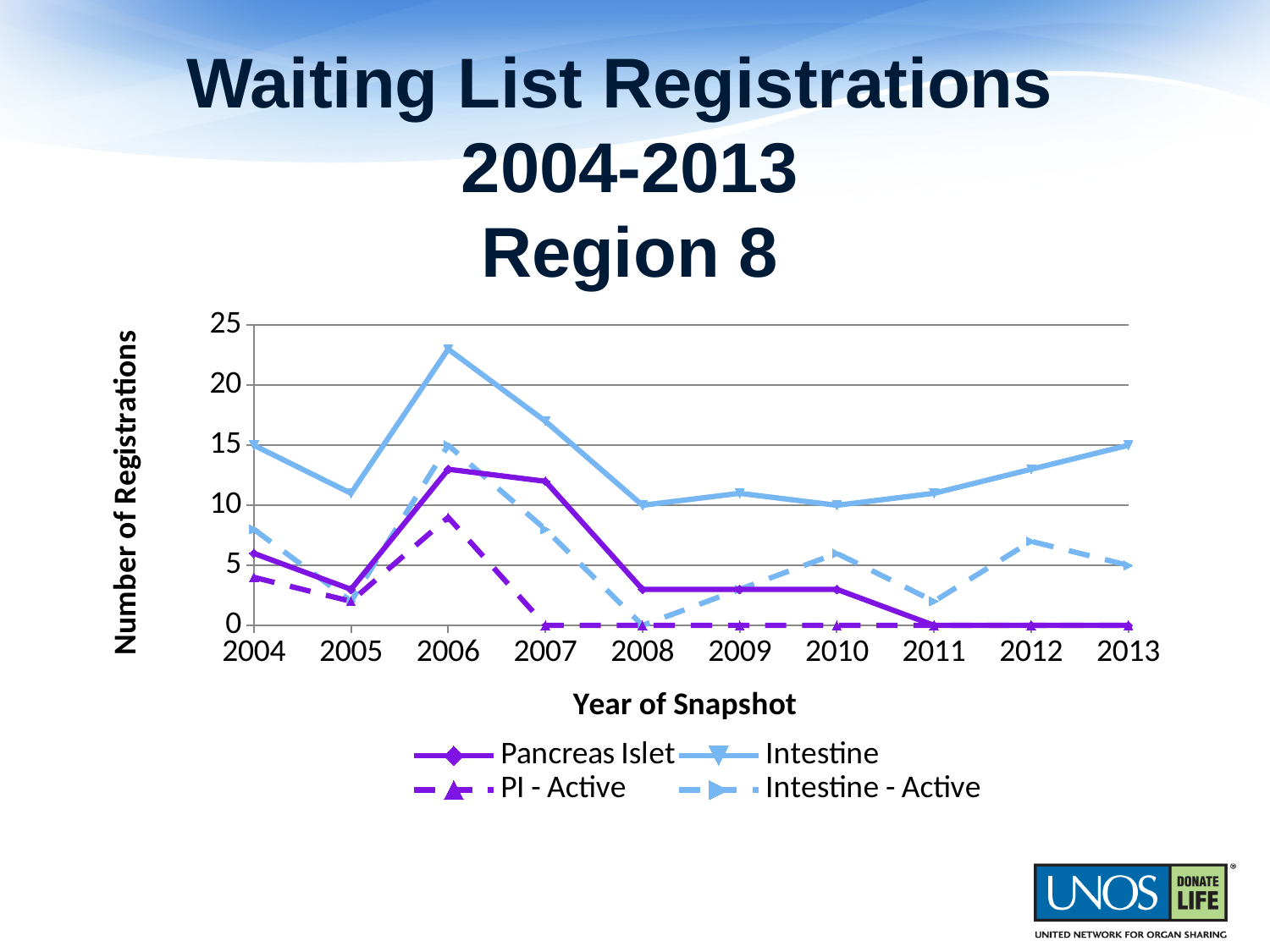
What is the value for Intestine in 2013? 15 What is the value for Intestine in 2004? 15 Is the value for Intestine in 2006 greater or less than 20? greater How many years are shown on the x axis? 10 Which series has the larger value in 2007, Intestine or Pancreas Islet? Intestine What is the value for Pancreas Islet in 2012? 0 Is the value for Pancreas Islet in 2005 greater or less than 5? less What is the value for PI - Active in 2009? 0 What type of chart is shown on the slide? line chart In which year does the Intestine series reach its highest value? 2006 How many series does the legend list? 4 What is the label of the y axis? Number of Registrations